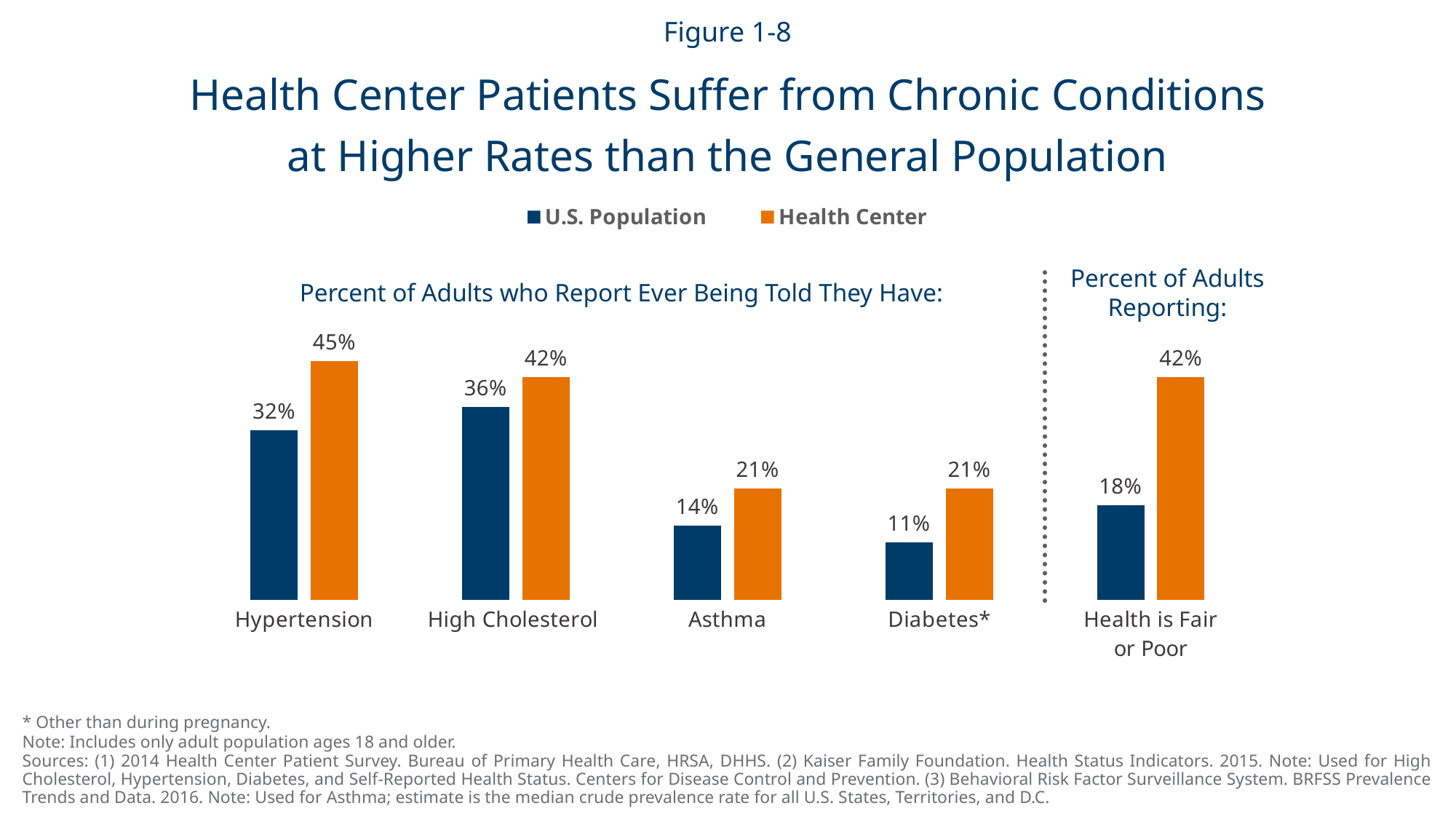
What is the difference between the Health Center and U.S. Population values for Health is Fair or Poor? 24% Which colour represents the Health Center series? Orange How many series does the legend list? 2 What is the U.S. Population value for Diabetes*? 11% What is the difference between the Health Center and U.S. Population values for Asthma? 7% What is the Health Center value for Hypertension? 45% What is the U.S. Population value for Health is Fair or Poor? 18% Which category has the highest Health Center value? Hypertension Which category has the lowest U.S. Population value? Diabetes* Which is larger: the U.S. Population value for Hypertension or the U.S. Population value for High Cholesterol? High Cholesterol What kind of chart is shown on the slide? Bar chart How many categories are shown on the x axis? 5